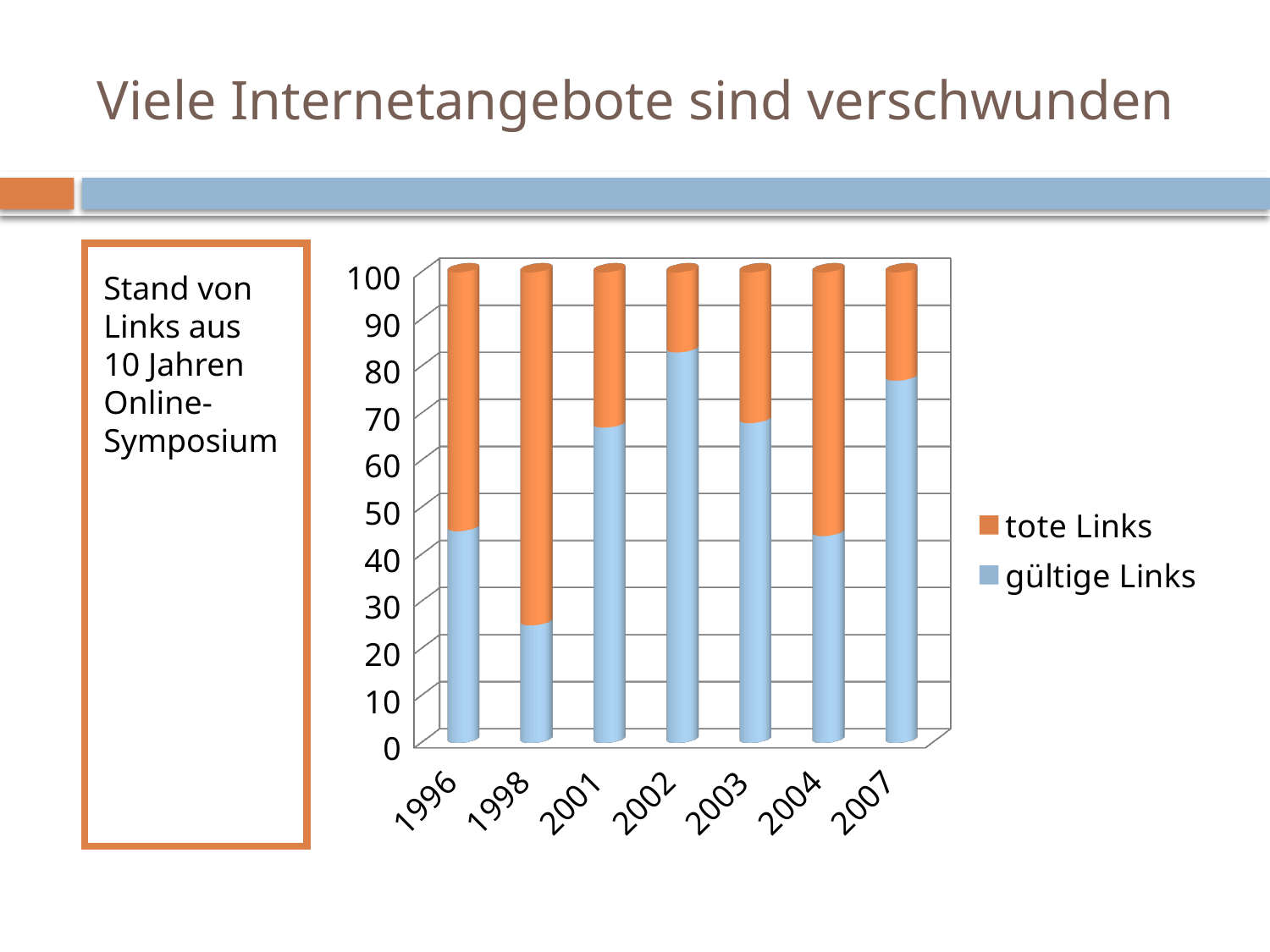
What is the total height of the stacked bar for 1996? 100 What kind of chart is shown on the slide? stacked bar chart Which year has the larger value for gültige Links, 1996 or 1998? 1996 Which year has the highest value for tote Links? 1998 Which year has the highest value for gültige Links? 2002 Which colour represents tote Links in the chart? orange Is the value for gültige Links in 1998 greater or less than 30? less Which year has the lowest value for gültige Links? 1998 Is the value for gültige Links in 2007 greater or less than 70? greater How many years are shown on the x axis of the chart? 7 Is the value for gültige Links in 1996 greater or less than 50? less How many series does the chart legend list? 2